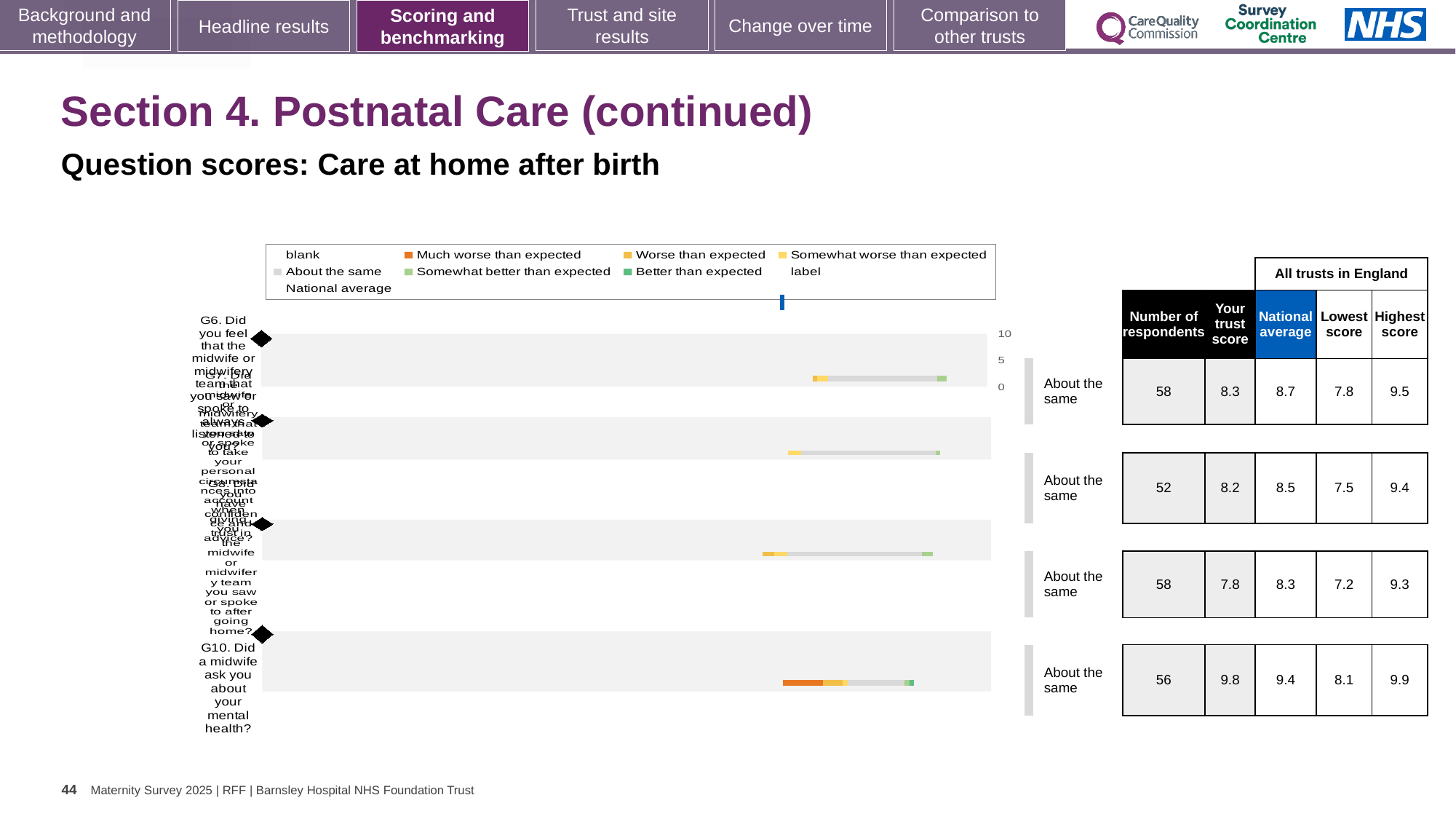
How many question bars are plotted in the chart? 4 What benchmark category label is shown next to each of the four bars? About the same What kind of chart is shown on the slide? bar chart In the table, which row has the lowest 'Your trust score'? the third row (G8), 7.8 In the table, what is the lowest score for the third row (G8)? 7.2 In the table, which is larger for the bottom row (G10): 'Your trust score' or the national average? Your trust score In the table, what is the number of respondents for the bottom row (G10, mental health)? 56 In the table, what is the national average for the top row (G6)? 8.7 In the chart legend, what colour is used for 'Much worse than expected'? orange In the table, what is 'Your trust score' for the bottom row (G10)? 9.8 In the table, what is the difference between the highest score and the lowest score for the bottom row (G10)? 1.8 In the table, which row has the highest 'Your trust score'? the bottom row (G10), 9.8